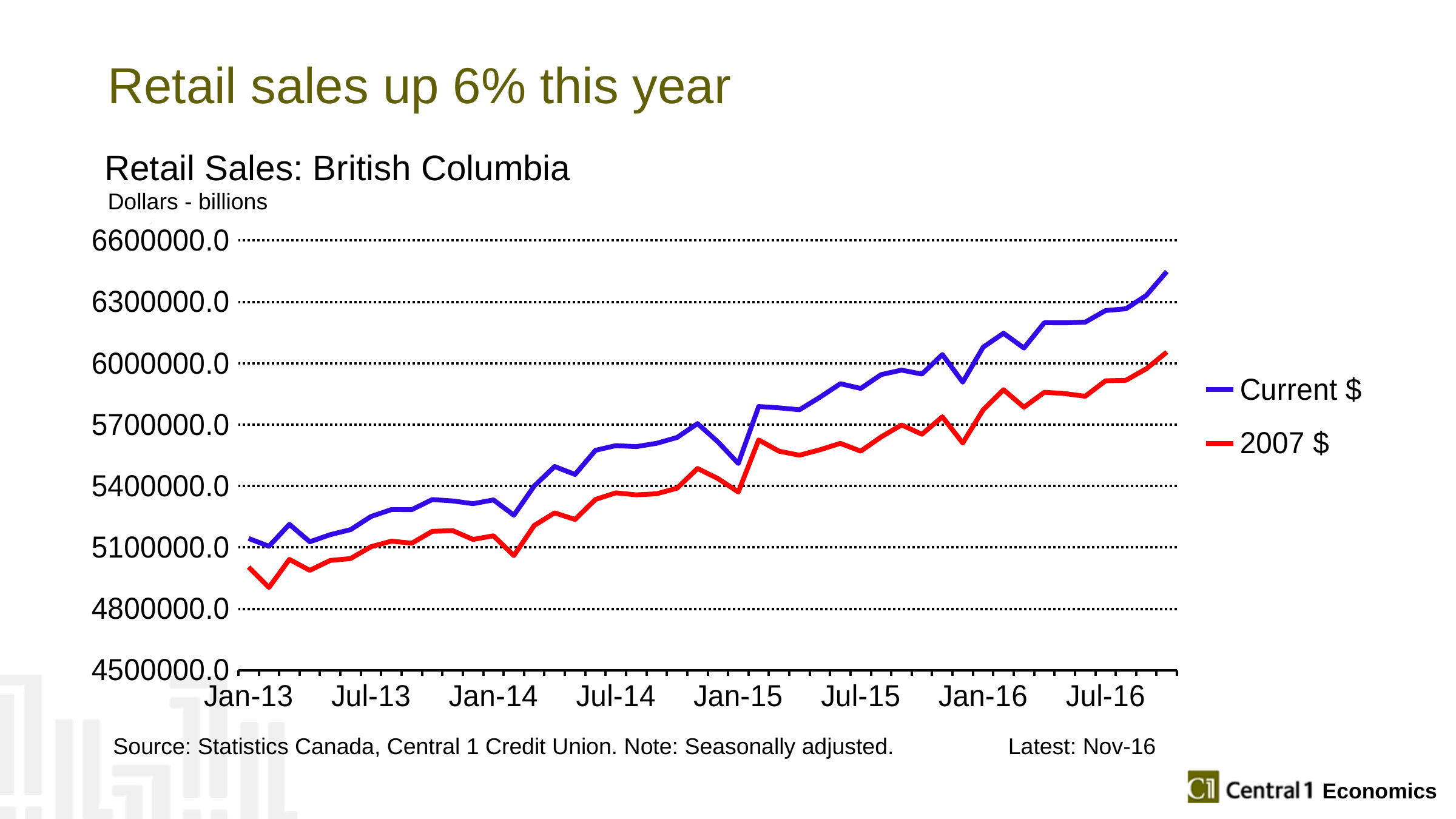
Is the 2007 $ value at Jan-13 greater or less than 5100000.0? less Do the Current $ values generally rise or fall from Jan-13 to the end of the period? rise Is the highest Current $ value at the start or the end of the period shown? end Do the 2007 $ values generally rise or fall over the period shown? rise Which series is higher at Jul-16, Current $ or 2007 $? Current $ What are the two series named in the legend? Current $ and 2007 $ What kind of chart is shown on the slide? line chart Is the 2007 $ value at Jul-16 greater or less than 6000000.0? less Is the Current $ value at Jan-13 greater or less than 5400000.0? less What is the title of the chart? Retail Sales: British Columbia How many series does the legend list? 2